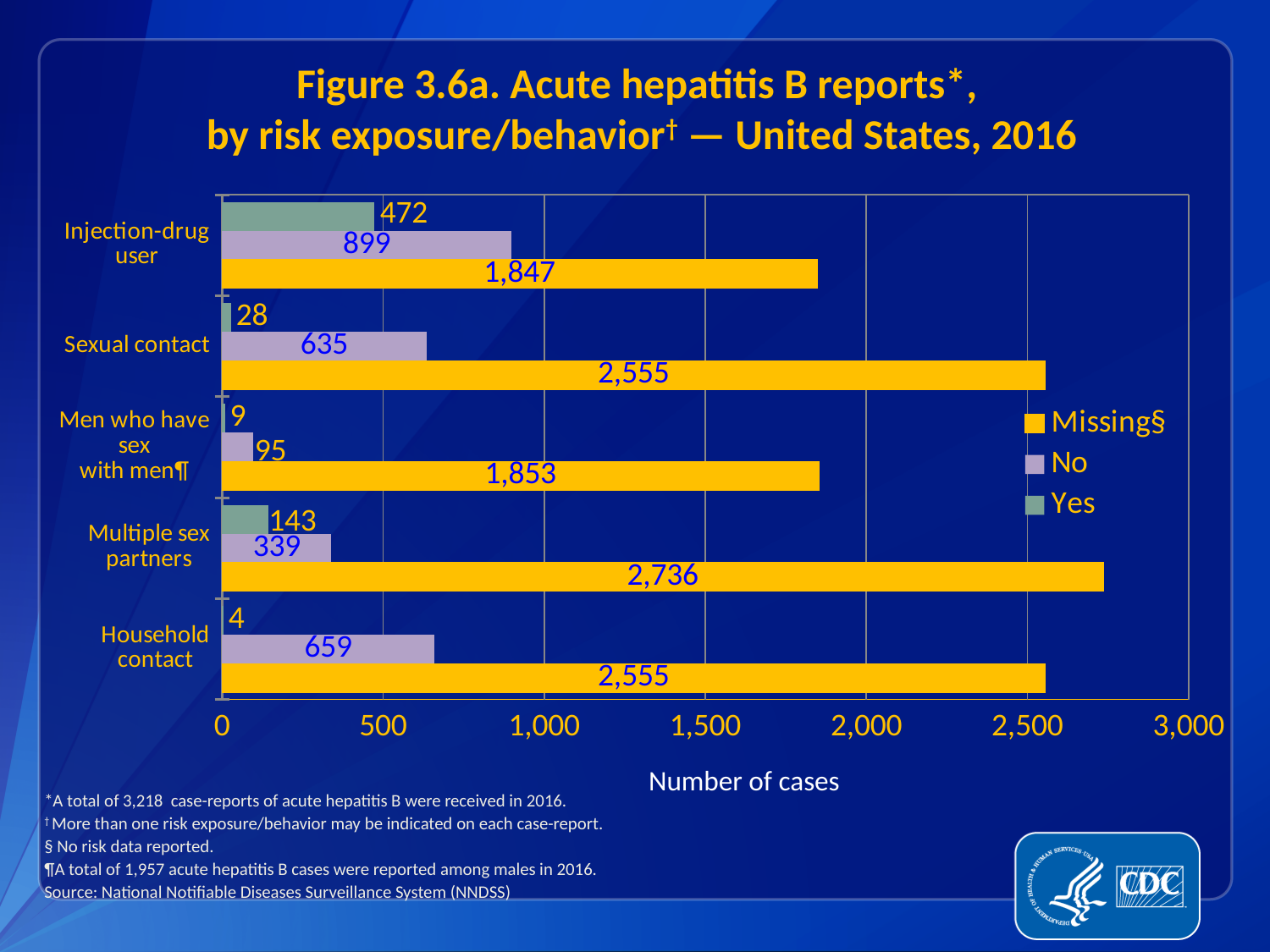
Which is larger: the 'Yes' value for Multiple sex partners or the 'Yes' value for Sexual contact? Multiple sex partners What is the number of cases for 'Missing' in the Multiple sex partners category? 2,736 What is the number of cases for 'Yes' among injection-drug users? 472 What is the label of the x axis? Number of cases How many risk exposure/behavior categories are shown on the chart? 5 How many series does the legend list? 3 Which risk exposure category has the lowest 'Yes' value? Household contact Is the 'Missing' value for Men who have sex with men greater or less than 2,000? less What is the number of cases for 'No' in the Household contact category? 659 Which risk exposure category has the highest 'Missing' value? Multiple sex partners What is the difference between the 'No' values for Injection-drug user and Sexual contact? 264 What kind of chart is shown on the slide? Bar chart